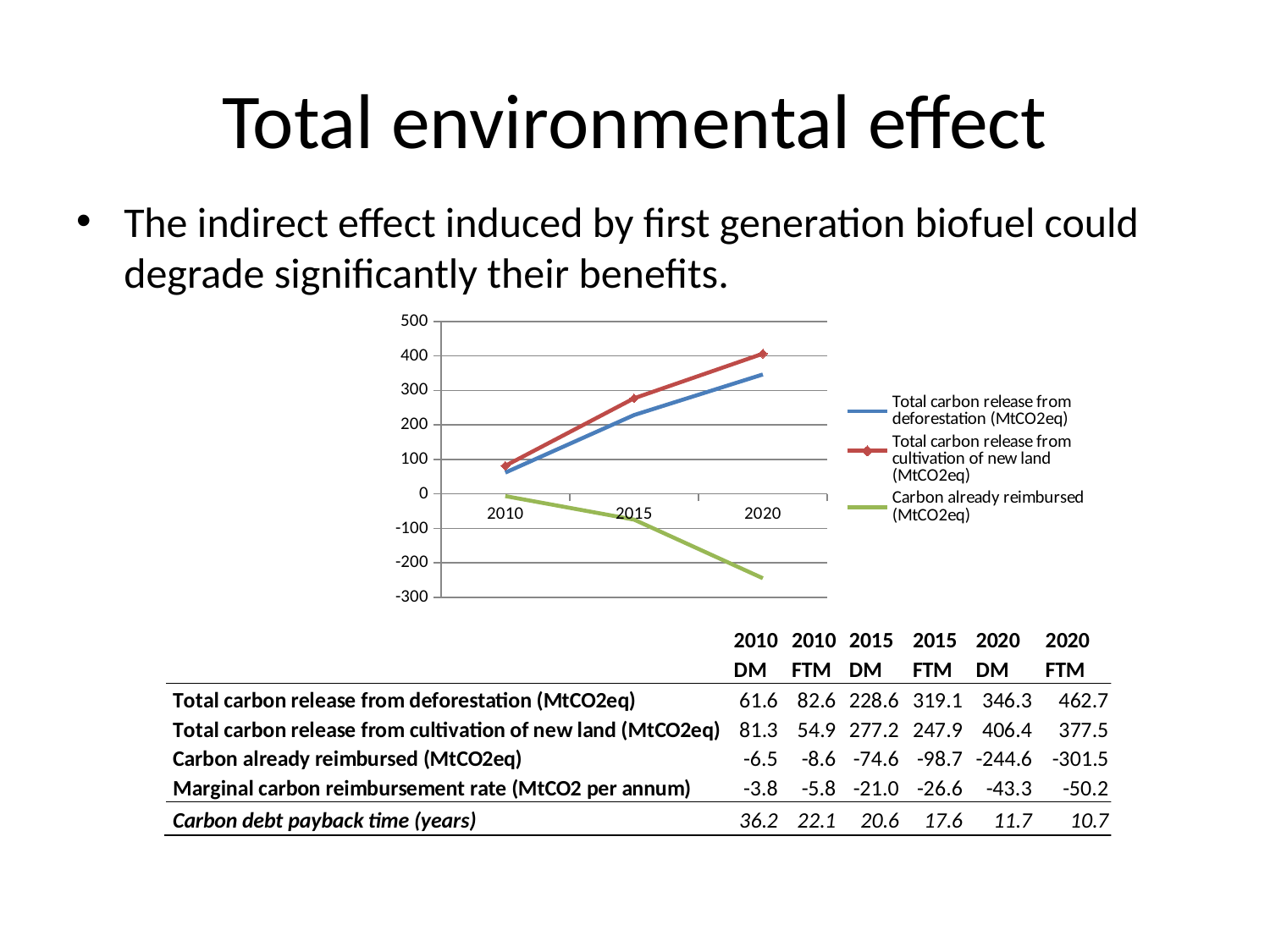
Does the total carbon release from deforestation rise or fall from 2010 to 2020 on the chart? rise Is the value for total carbon release from deforestation in 2020 greater or less than 300? greater Which series has the highest value in 2020 on the chart? Total carbon release from cultivation of new land (MtCO2eq) Which series has the lowest value in 2020 on the chart? Carbon already reimbursed (MtCO2eq) Which series on the chart is drawn in green? Carbon already reimbursed (MtCO2eq) Is the value for total carbon release from deforestation in 2010 greater or less than 100? less Does the carbon already reimbursed series rise or fall from 2010 to 2020 on the chart? fall In 2020, which is larger on the chart: total carbon release from deforestation or total carbon release from cultivation of new land? Total carbon release from cultivation of new land Is the value for carbon already reimbursed in 2020 greater or less than -200? less How many series does the chart legend list? 3 How many years are shown on the x axis of the chart? 3 What kind of chart is shown on the slide? line chart